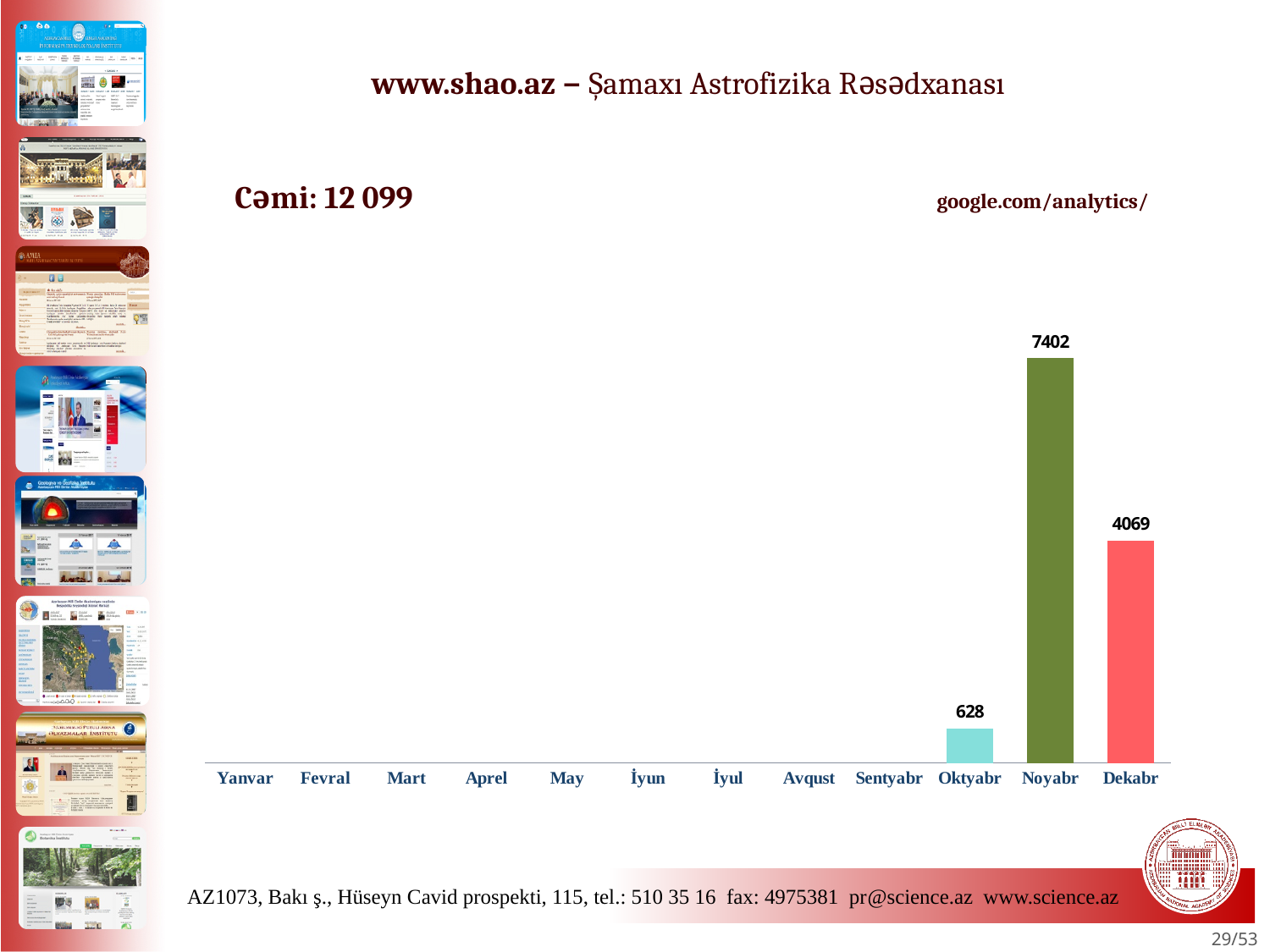
What is the value for Dekabr? 4069 What is the difference between the values for Noyabr and Dekabr? 3333 What is the total (Cəmi) of the values shown on the slide? 12 099 Which is larger, the value for Dekabr or the value for Oktyabr? Dekabr What is the value for Oktyabr? 628 Which website does the chart on the slide refer to? www.shao.az Which month has the highest bar? Noyabr What is the value for Noyabr? 7402 What is the difference between the values for Dekabr and Oktyabr? 3441 How many month categories are shown on the x axis? 12 What kind of chart is shown on the slide? bar chart Among the months with a bar shown, which has the lowest value? Oktyabr